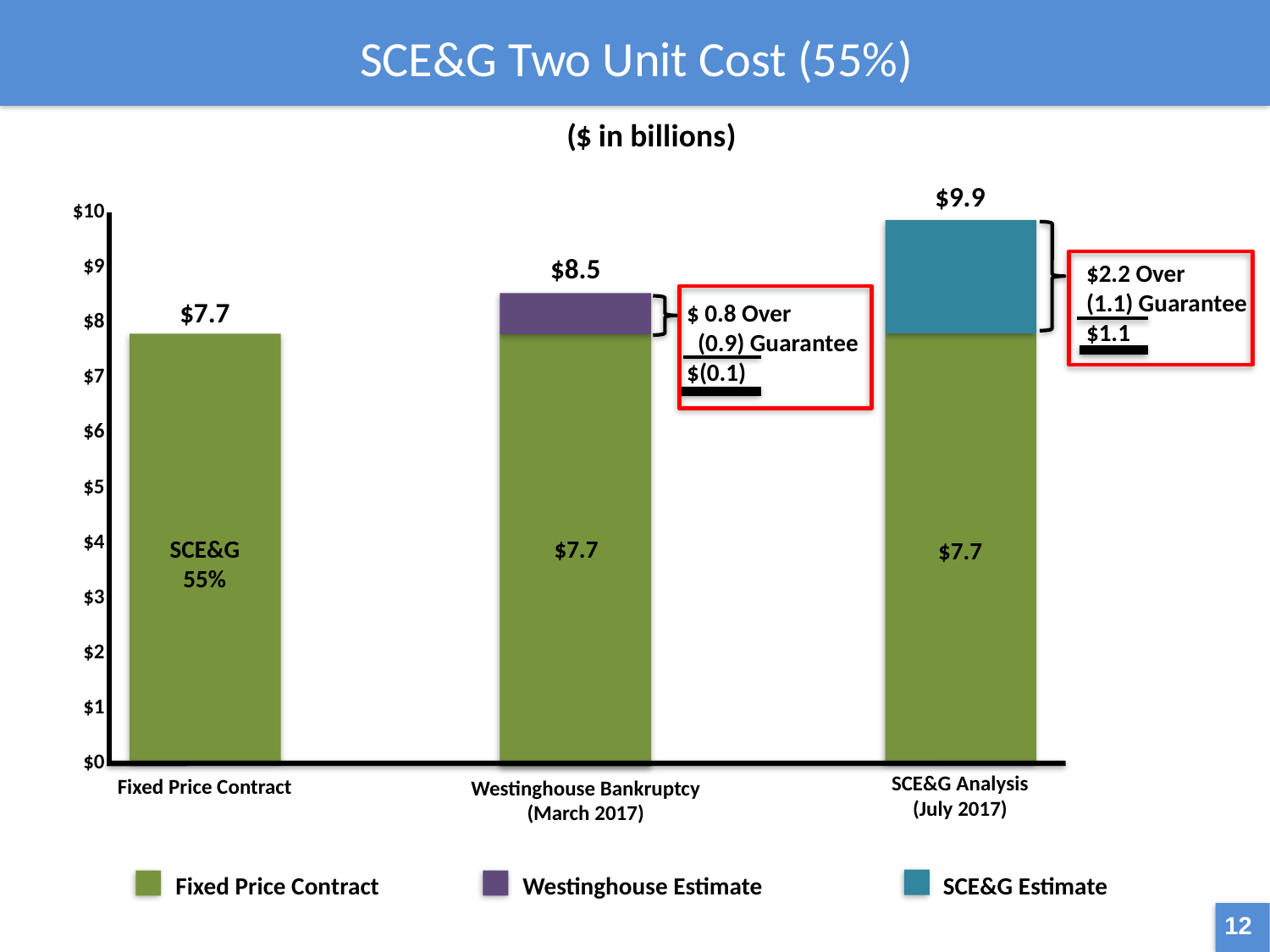
Which category has the lowest total bar? Fixed Price Contract What is the difference between the total for Westinghouse Bankruptcy (March 2017) and the total for Fixed Price Contract? $0.8 What is the total value shown above the bar for SCE&G Analysis (July 2017)? $9.9 What is the total value shown above the bar for Westinghouse Bankruptcy (March 2017)? $8.5 Do the total bar values rise or fall from left to right across the x axis? Rise What kind of chart is shown on the slide? Stacked bar chart Which category has the highest total bar? SCE&G Analysis (July 2017) How many series does the legend list? 3 Which is larger, the total for Westinghouse Bankruptcy (March 2017) or the total for SCE&G Analysis (July 2017)? SCE&G Analysis (July 2017) How many categories are shown on the x axis? 3 What is the difference between the total for SCE&G Analysis (July 2017) and the total for Fixed Price Contract? $2.2 What is the value of the Fixed Price Contract segment in the SCE&G Analysis (July 2017) bar? $7.7